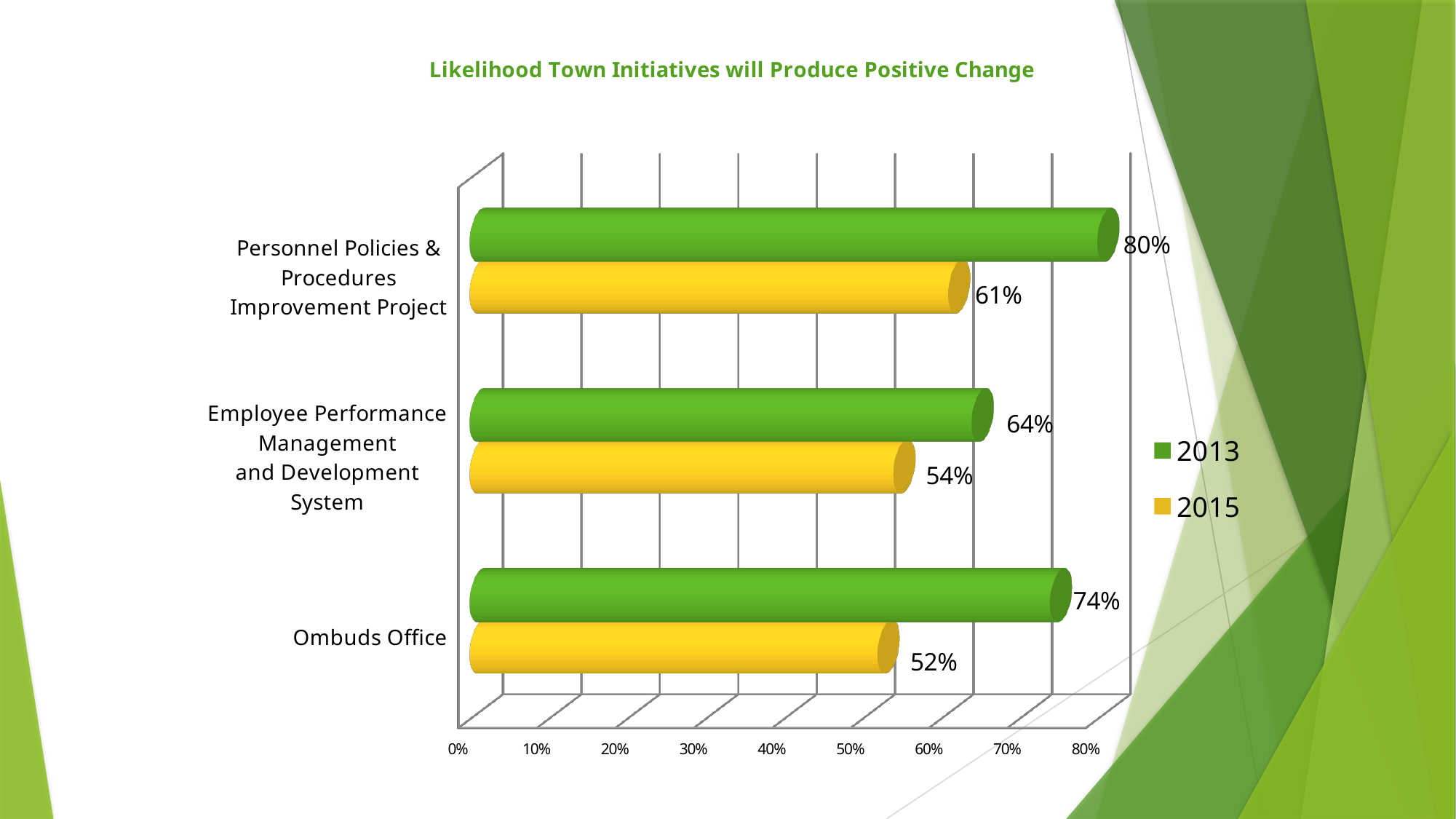
What kind of chart is shown on the slide? Bar chart What is the difference between the 2013 and 2015 values for Ombuds Office? 22% Which is larger for Employee Performance Management and Development System, the 2013 value or the 2015 value? 2013 How many categories are shown on the chart? 3 What is the 2013 value for Ombuds Office? 74% What is the title of the chart? Likelihood Town Initiatives will Produce Positive Change Which category has the lowest 2015 value? Ombuds Office What is the 2013 value for Personnel Policies & Procedures Improvement Project? 80% How many series does the legend list? 2 What is the 2015 value for Ombuds Office? 52% Which category has the highest 2013 value? Personnel Policies & Procedures Improvement Project What is the 2015 value for Employee Performance Management and Development System? 54%